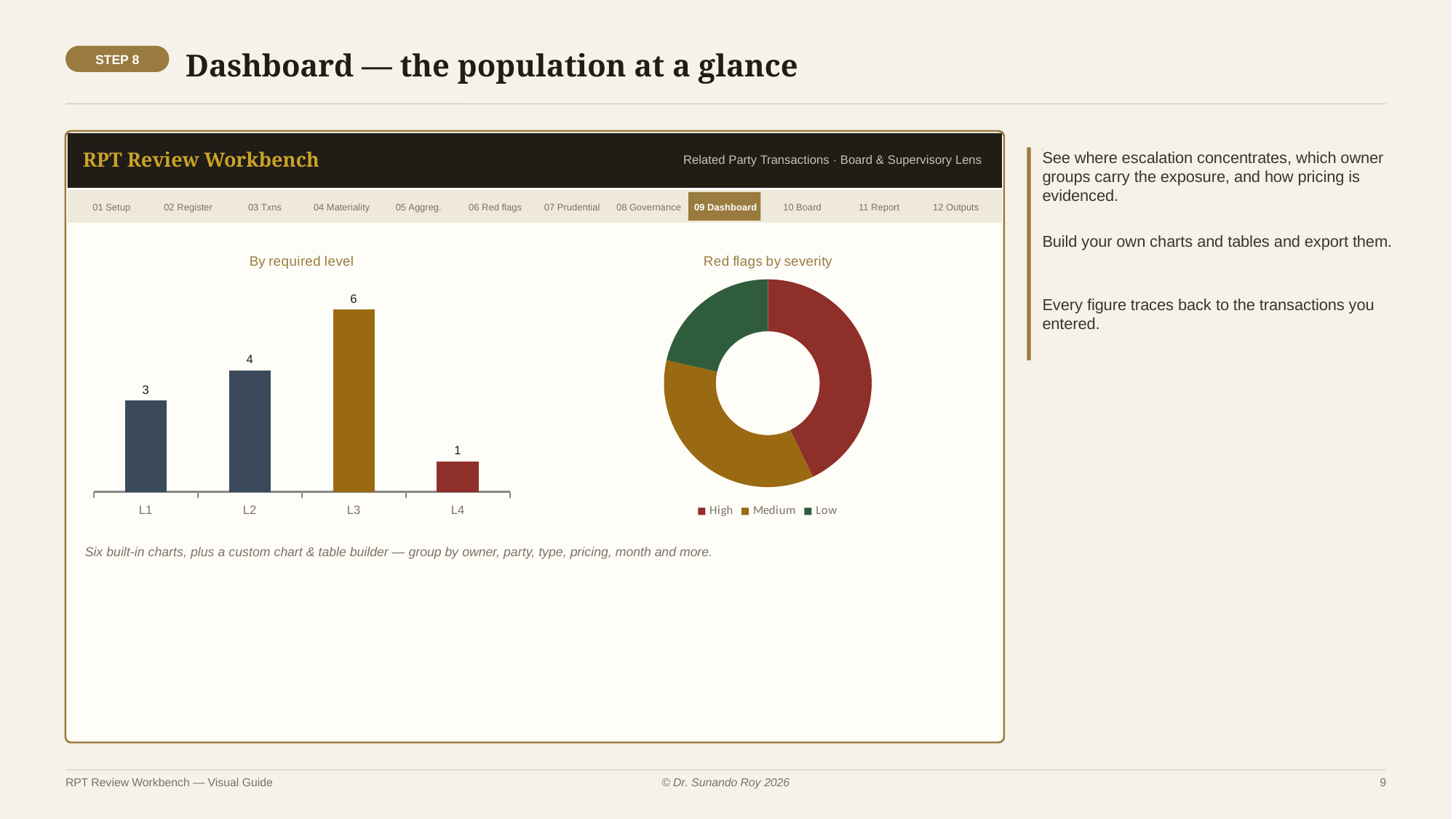
What kind of chart is 'By required level'? Bar chart How many entries does the legend of the 'Red flags by severity' chart list? 3 How many categories are shown in the 'By required level' chart? 4 In the 'Red flags by severity' chart, which colour represents Medium? Gold What kind of chart is 'Red flags by severity'? Doughnut chart In the 'By required level' chart, which is larger, the value for L2 or the value for L4? L2 In the 'By required level' chart, what is the value for L1? 3 In the 'Red flags by severity' chart, which severity has the smallest slice? Low In the 'By required level' chart, what is the difference between the values for L3 and L2? 2 In the 'By required level' chart, which level has the lowest value? L4 In the 'By required level' chart, which level has the highest value? L3 In the 'By required level' chart, what is the value for L3? 6